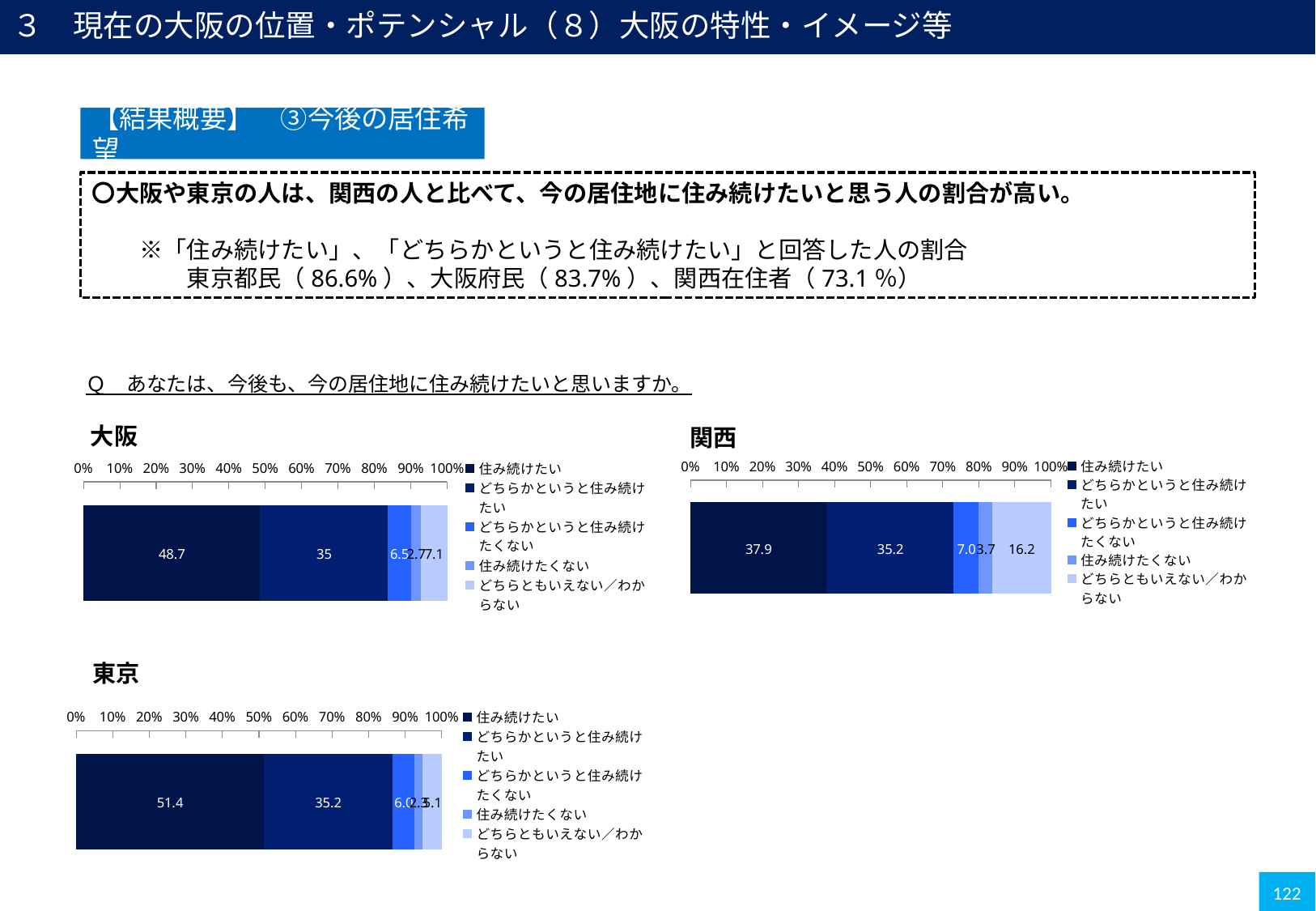
In the 関西 chart, what is the value for どちらともいえない／わからない? 16.2 In the 関西 chart, which series has the largest value? 住み続けたい In the 関西 chart, what is the difference between the 住み続けたい value and the どちらかというと住み続けたい value? 2.7 In the 関西 chart, what is the value for 住み続けたい? 37.9 What is the difference between the 住み続けたい value in the 東京 chart and the 住み続けたい value in the 大阪 chart? 2.7 In the 東京 chart, what is the value for 住み続けたい? 51.4 Is the value for 住み続けたい larger in the 東京 chart or the 大阪 chart? 東京 In the 東京 chart, what is the value for どちらかというと住み続けたい? 35.2 In the 大阪 chart, what is the value for 住み続けたい? 48.7 How many series does the legend of the 大阪 chart list? 5 In the 大阪 chart, what is the value for どちらかというと住み続けたい? 35 What kind of chart is the 東京 chart? Stacked bar chart